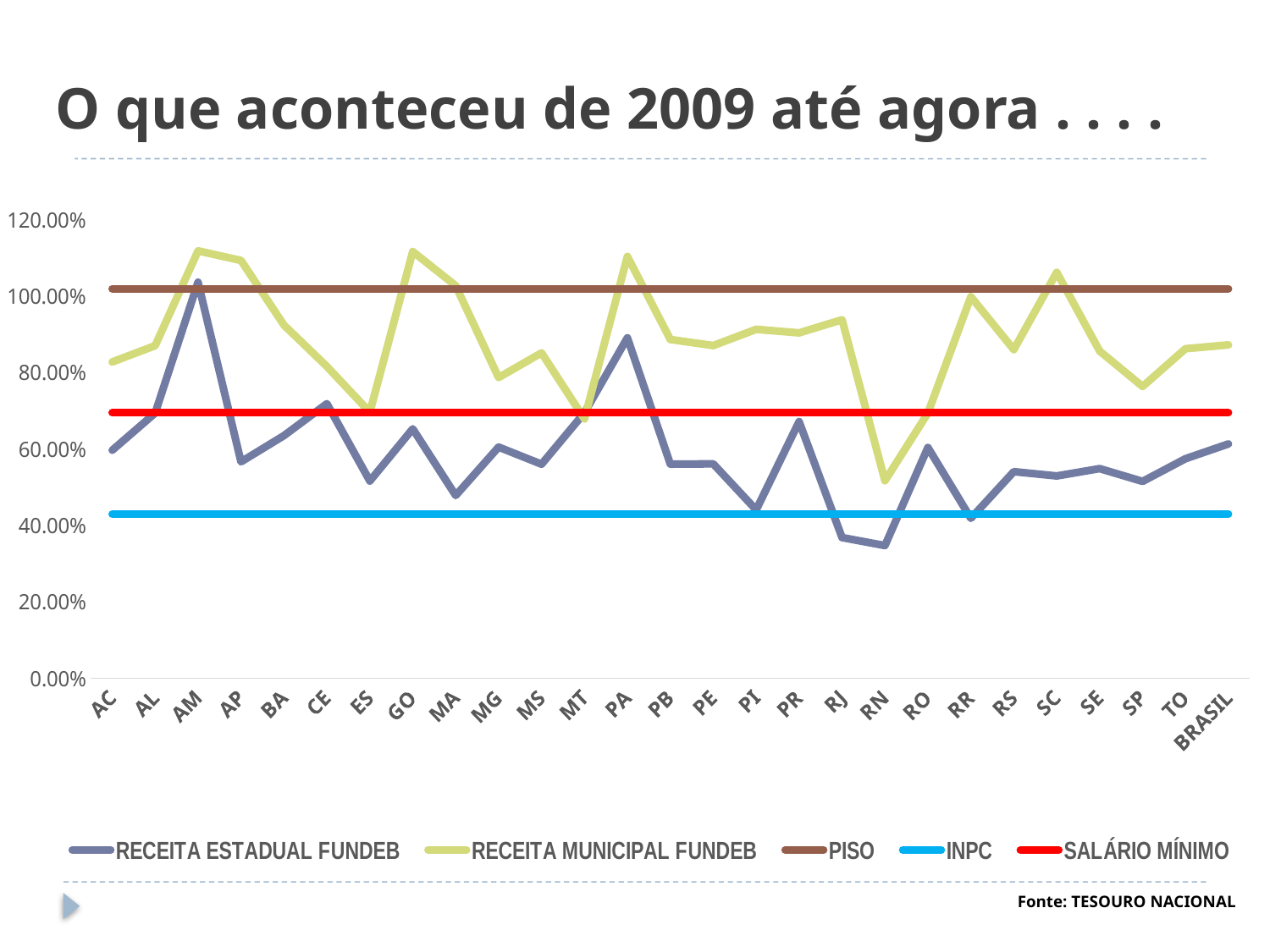
What kind of chart is shown on the slide? line chart How many series does the legend list? 5 Is the RECEITA ESTADUAL FUNDEB value for RJ greater or less than 40.00%? less At PA, which series has the larger value: RECEITA ESTADUAL FUNDEB or RECEITA MUNICIPAL FUNDEB? RECEITA MUNICIPAL FUNDEB At RN, which is larger: the RECEITA ESTADUAL FUNDEB value or the INPC line? INPC Which category has the lowest value for RECEITA MUNICIPAL FUNDEB? RN Which category has the highest value for RECEITA ESTADUAL FUNDEB? AM What source is cited below the chart? TESOURO NACIONAL How many categories are shown along the x axis? 27 Is the RECEITA MUNICIPAL FUNDEB value for MT greater or less than 80.00%? less Which category has the lowest value for RECEITA ESTADUAL FUNDEB? RN Is the RECEITA MUNICIPAL FUNDEB value for GO greater or less than 100.00%? greater